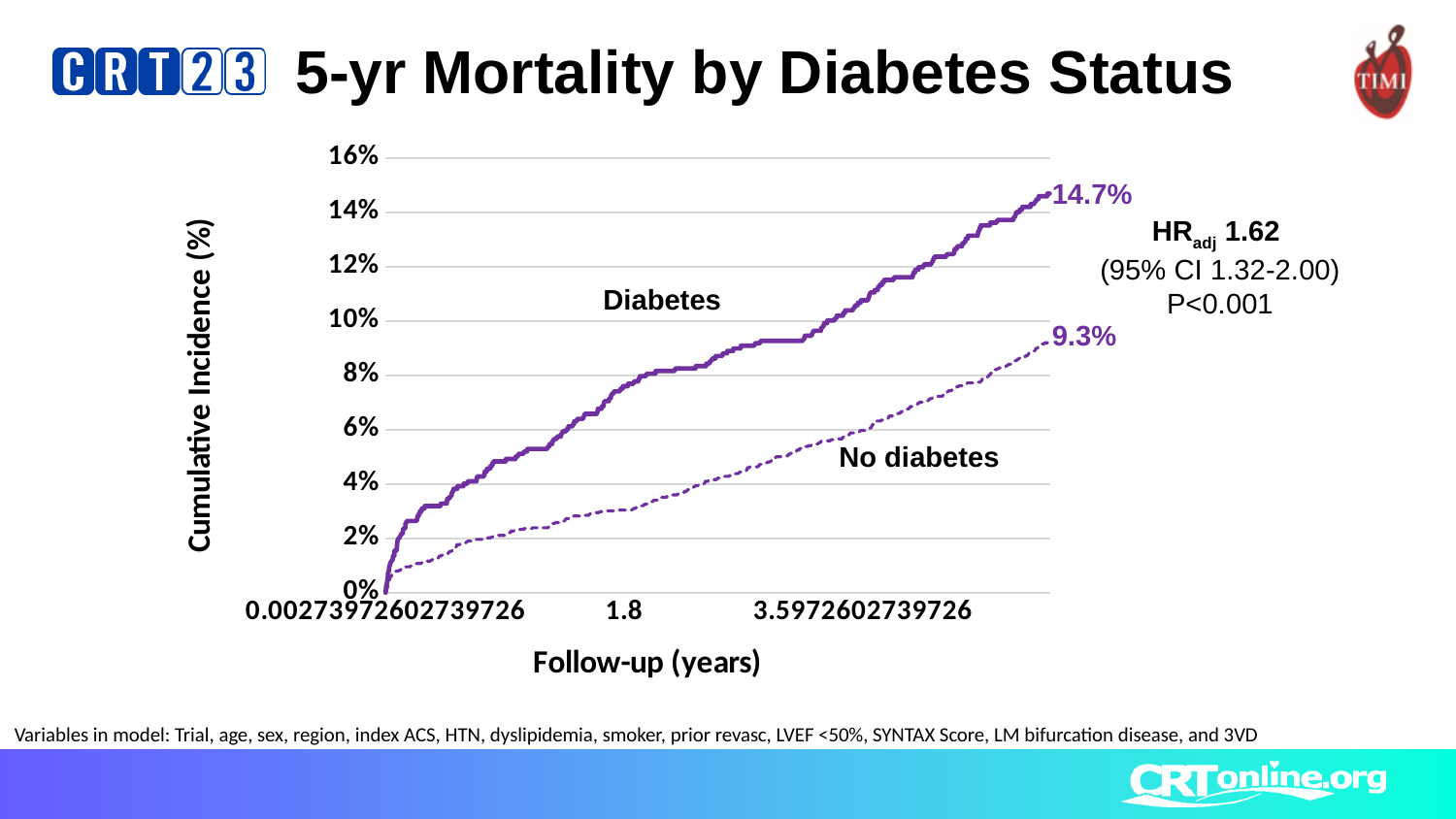
Is the final cumulative incidence for the No diabetes group greater or less than 10%? less Do the cumulative incidence curves rise or fall as follow-up time increases? Rise What is the 5-year cumulative incidence for the No diabetes group at the end of follow-up? 9.3% What is the label of the y-axis of the chart? Cumulative Incidence (%) What kind of chart is shown on the slide? Line chart How many groups (curves) are plotted on the chart? 2 What is the 5-year cumulative incidence for the Diabetes group at the end of follow-up? 14.7% Which group has the lowest cumulative incidence at the end of follow-up? No diabetes What is the title of the chart on the slide? 5-yr Mortality by Diabetes Status Is the final cumulative incidence for the Diabetes group greater or less than 14%? greater Which group has the higher cumulative incidence at the end of follow-up, Diabetes or No diabetes? Diabetes What is the difference in percentage points between the final cumulative incidence of the Diabetes and No diabetes groups? 5.4 percentage points